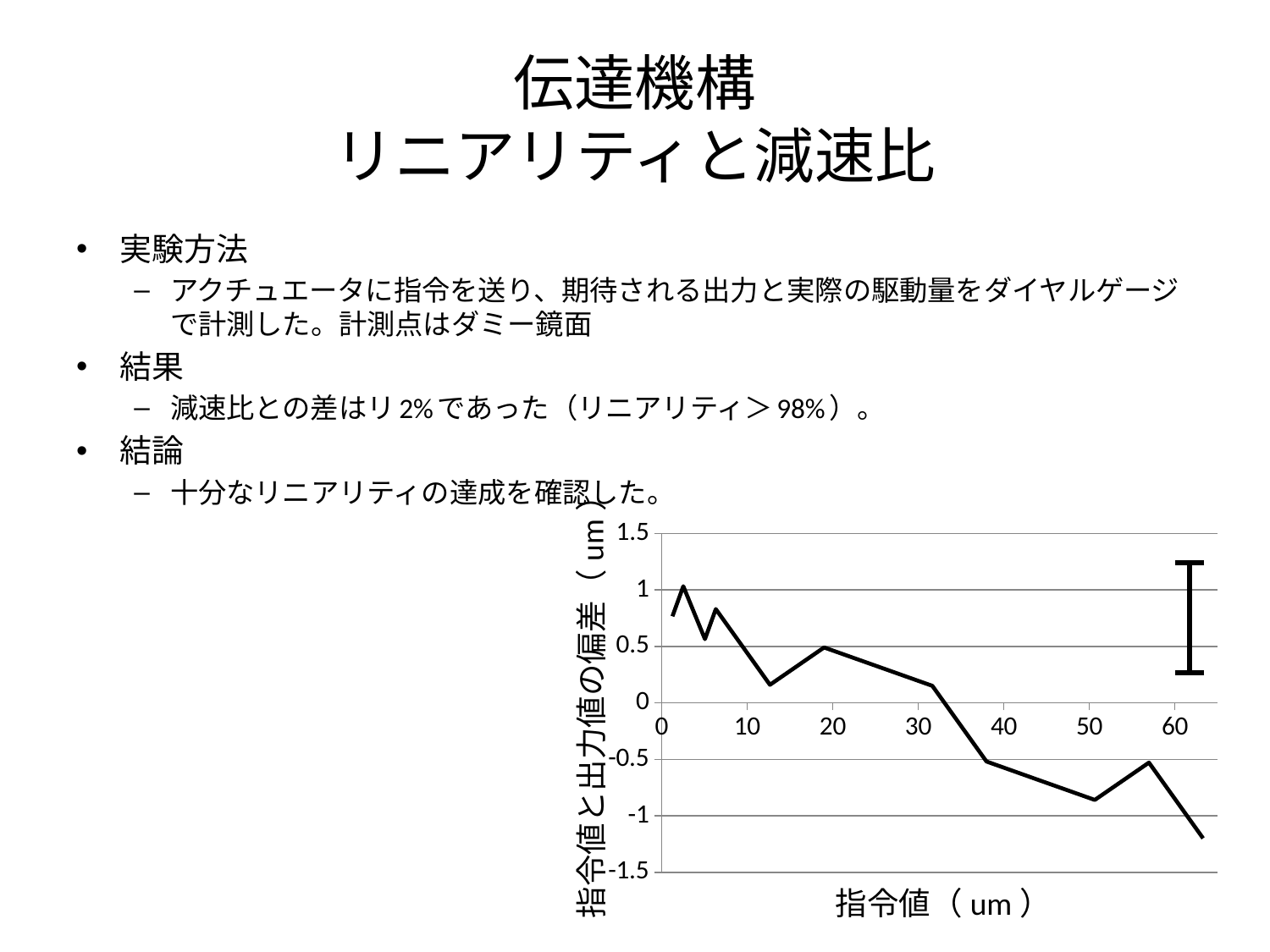
Which is larger: the plotted value near a command value of 20 um or the plotted value near 40 um? the value near 20 um Is the lowest plotted value on the chart greater or less than -1? less What is the label of the y axis of the chart? 指令値と出力値の偏差（um） Is the plotted value at a command value of 40 um greater or less than 0? less Overall, do the plotted values rise or fall as the command value (指令値) increases along the x axis? fall Is the plotted value at a command value of 10 um greater or less than 0? greater What is the label of the x axis of the chart? 指令値（um） What kind of chart is shown on the slide? line chart